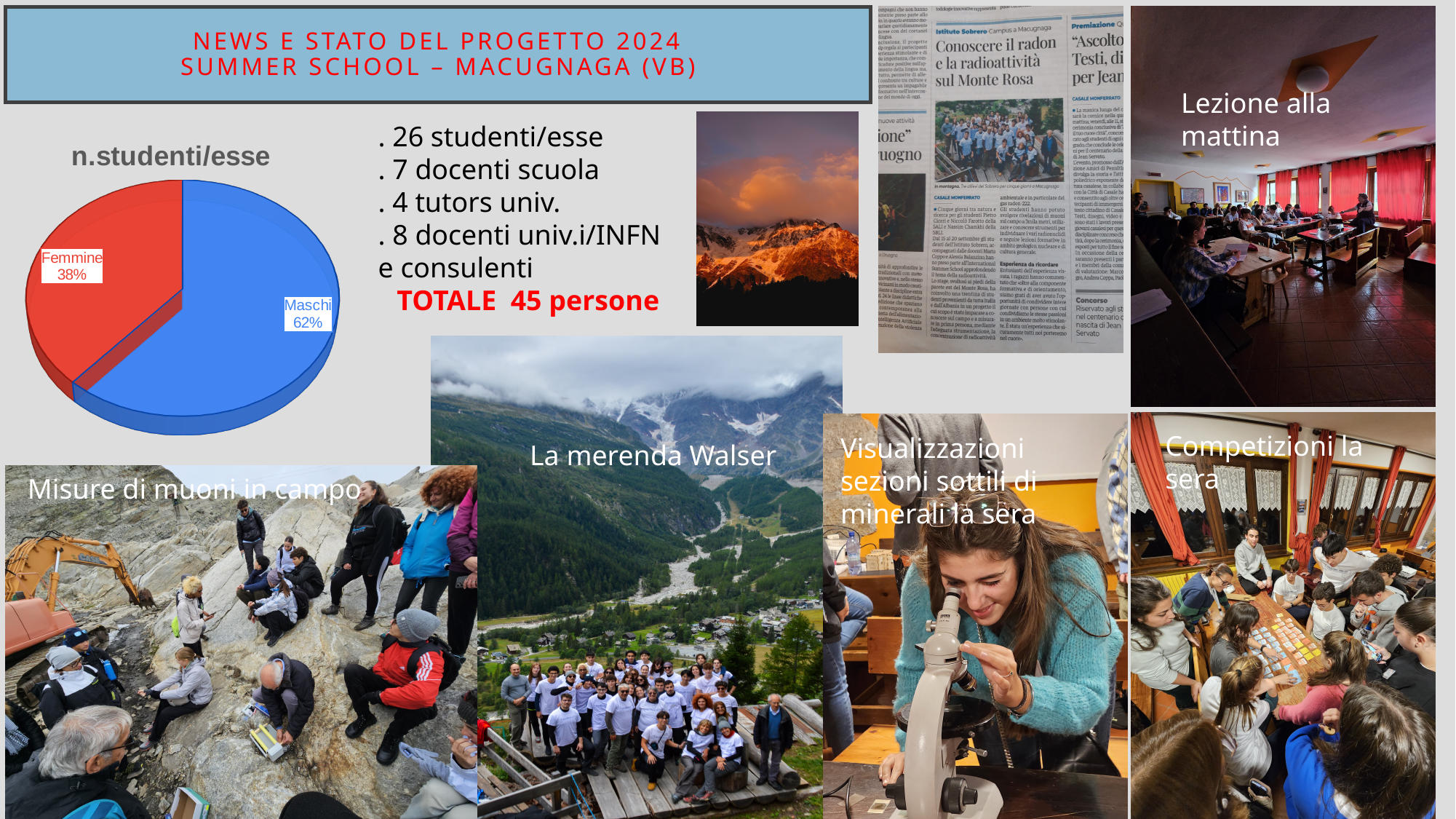
What is the difference in percentage points between the Maschi and Femmine slices? 24% Which is larger in the pie chart, Femmine or Maschi? Maschi How many slices does the pie chart have? 2 What is the title of the pie chart? n.studenti/esse What colour is the Maschi slice of the pie chart? blue What kind of chart is shown on the slide? pie chart What share of the pie chart is labelled Maschi? 62% Which slice of the pie chart is the smallest? Femmine Is the share for Femmine greater or less than 50%? less What share of the pie chart is labelled Femmine? 38% Which slice of the pie chart is the largest? Maschi